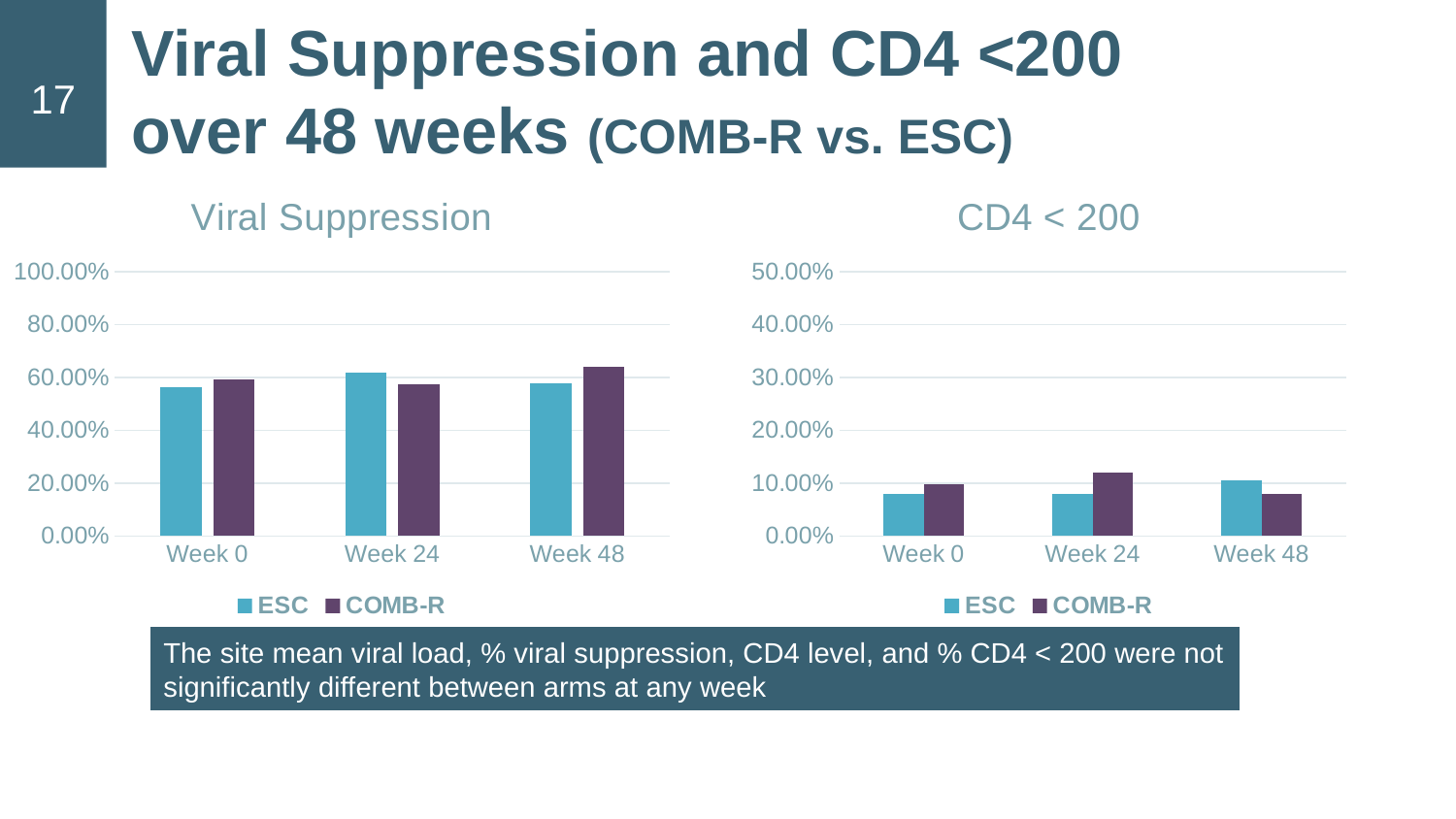
In the CD4 < 200 chart, is the value for ESC at Week 0 greater or less than 10.00%? less How many series does the legend of the CD4 < 200 chart list? 2 In the Viral Suppression chart, which is larger at Week 24, ESC or COMB-R? ESC In the CD4 < 200 chart, is the value for COMB-R at Week 24 greater or less than 10.00%? greater In the CD4 < 200 chart, which is larger at Week 48, ESC or COMB-R? ESC In the Viral Suppression chart, which is larger at Week 48, ESC or COMB-R? COMB-R In the Viral Suppression chart, is the value for ESC at Week 0 greater or less than 40.00%? greater How many week categories are shown on the x axis of the Viral Suppression chart? 3 In the CD4 < 200 chart, which week has the highest COMB-R value? Week 24 What is the title of the chart on the right side of the slide? CD4 < 200 What kind of chart is the Viral Suppression chart? bar chart